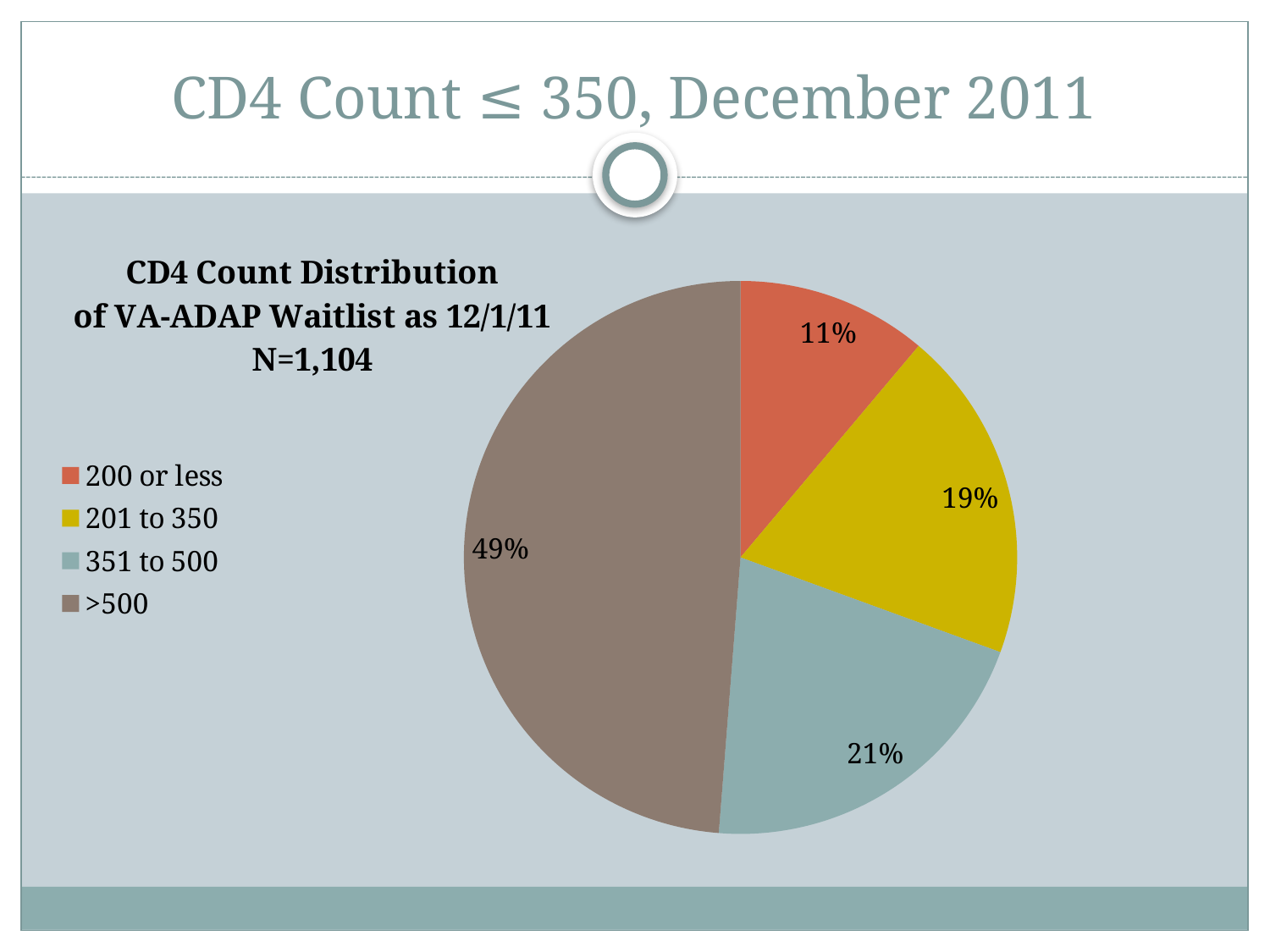
What colour is the "200 or less" slice in the legend? Orange-red What share of the pie does the "200 or less" category represent? 11% What kind of chart is shown on the slide? Pie chart What is the value shown for the "351 to 500" slice? 21% Which category has the smallest slice of the pie? 200 or less How many categories are shown in the pie chart? 4 What share of the pie does the ">500" category represent? 49% Which category has the largest slice of the pie? >500 Which is larger, the "201 to 350" slice or the "351 to 500" slice? 351 to 500 What is the value shown for the "201 to 350" slice? 19% What is the difference in percentage points between the ">500" slice and the "351 to 500" slice? 28 What is the N value stated in the chart title? N=1,104